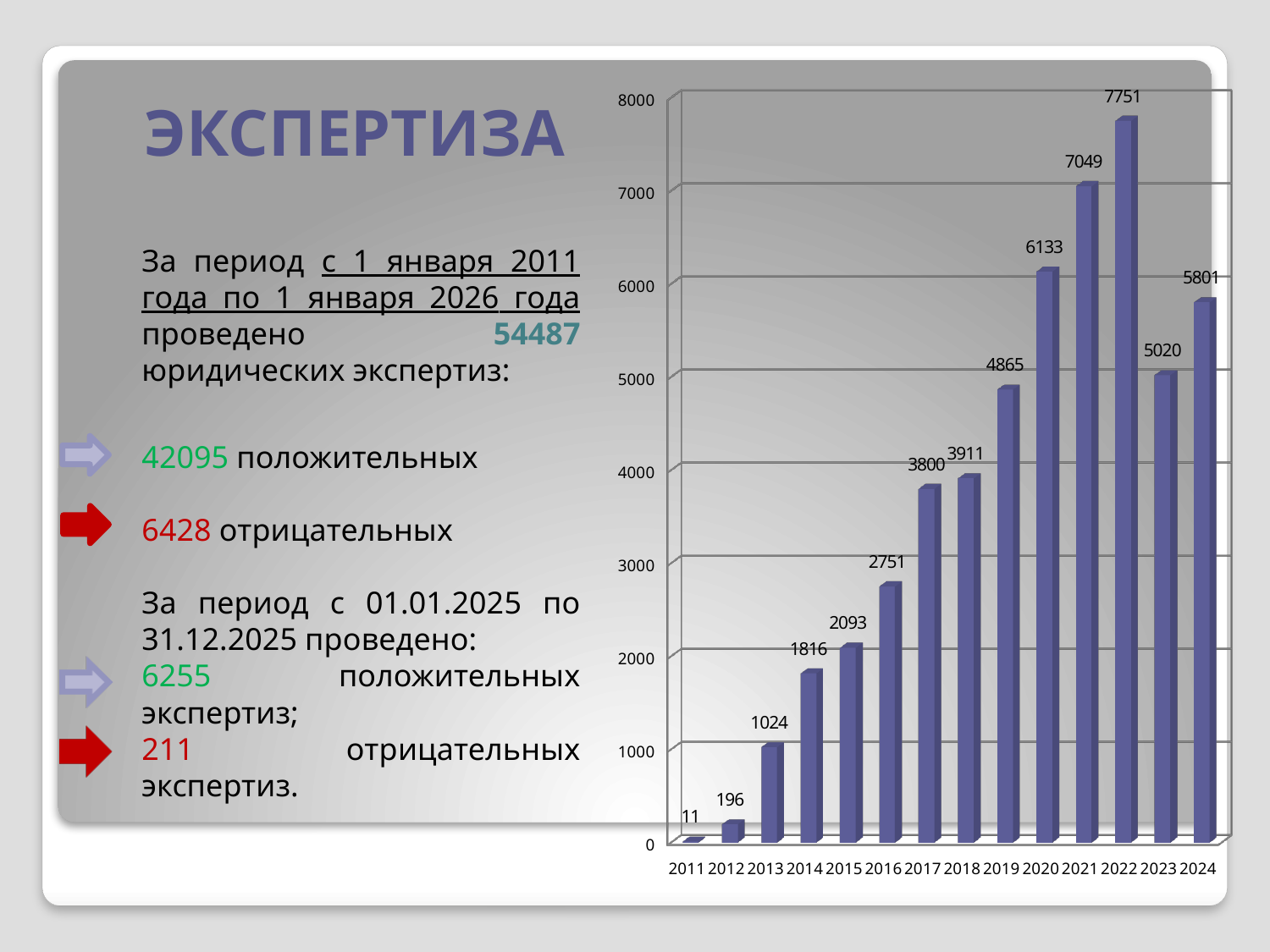
What kind of chart is shown on the slide? bar chart Which year has the highest value? 2022 Which year has the lowest value? 2011 What is the value for 2019? 4865 What is the value for 2013? 1024 Do the values rise or fall from 2011 to 2022? rise What is the value for 2022? 7751 How many years are shown on the x axis? 14 Which is larger, the value for 2021 or the value for 2024? 2021 What is the difference between the values for 2022 and 2023? 2731 Is the value for 2020 greater or less than 6000? greater What is the difference between the values for 2024 and 2023? 781